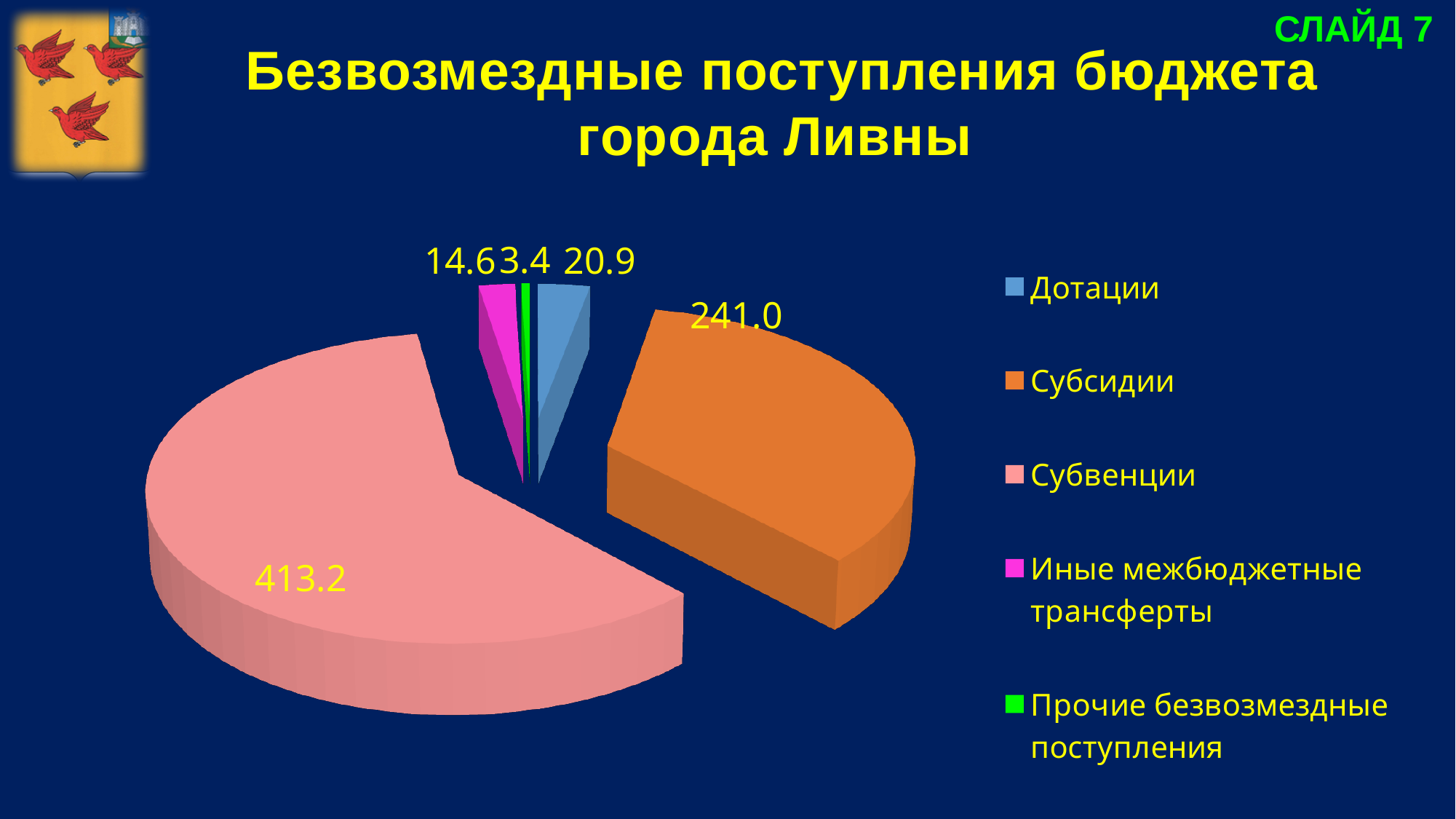
What is the difference between the values for Субвенции and Субсидии? 172.2 Which category has the largest slice of the pie? Субвенции What is the value for Иные межбюджетные трансферты? 14.6 What is the title of the slide containing the chart? Безвозмездные поступления бюджета города Ливны What is the value for Прочие безвозмездные поступления? 3.4 What is the value for Дотации? 20.9 What is the value for Субсидии? 241.0 Which category has the smallest slice of the pie? Прочие безвозмездные поступления What is the value for Субвенции? 413.2 What type of chart is shown on the slide? Pie chart How many categories does the legend list? 5 Which is larger, the value for Дотации or the value for Иные межбюджетные трансферты? Дотации